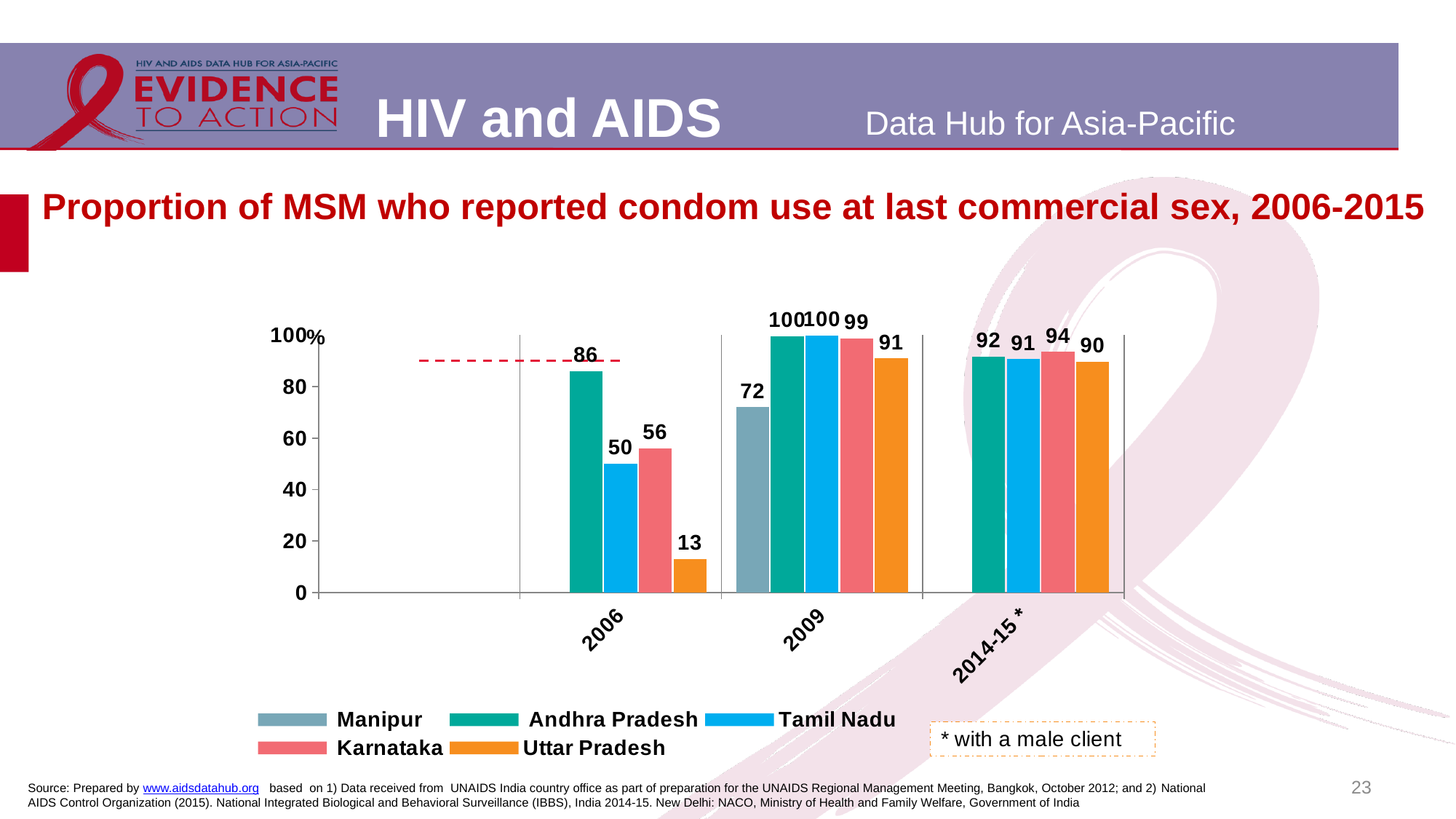
What value is shown for Uttar Pradesh in 2006? 13 Does the value for Uttar Pradesh rise or fall from 2006 to 2009? Rise Which state has the lowest value in 2006? Uttar Pradesh What value is shown for Andhra Pradesh in 2006? 86 What kind of chart is shown on the slide? Bar chart How many series does the legend list? 5 How many time periods are shown on the x axis? 3 What is the difference between the Karnataka and Tamil Nadu values in 2006? 6 Which is larger in 2014-15, the value for Andhra Pradesh or the value for Uttar Pradesh? Andhra Pradesh What value is shown for Manipur in 2009? 72 What value is shown for Karnataka in 2014-15? 94 Which state has the lowest value in 2009? Manipur